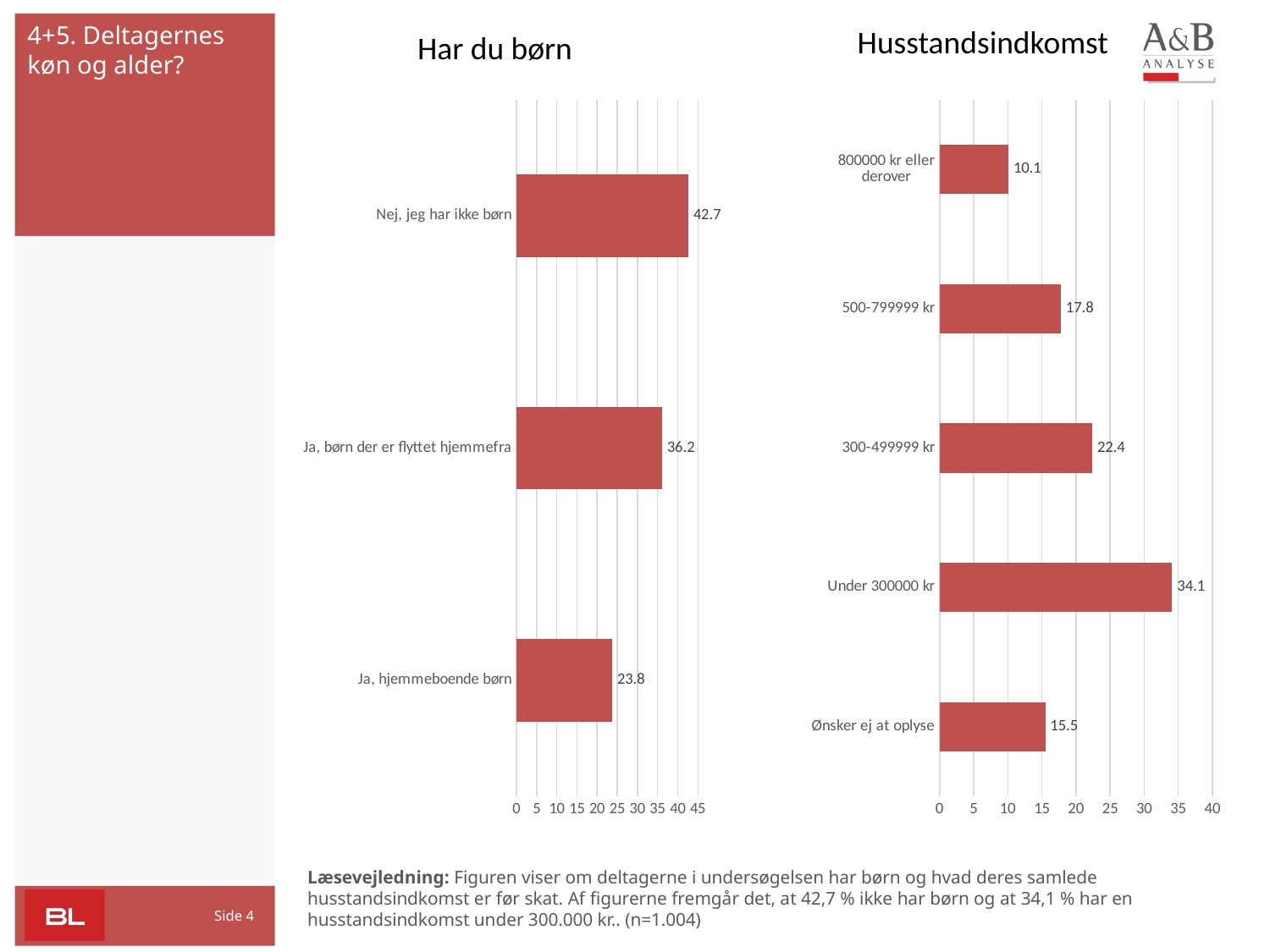
In the 'Har du børn' chart, which category has the lowest value? Ja, hjemmeboende børn In the 'Har du børn' chart, what is the value for 'Ja, hjemmeboende børn'? 23.8 In the 'Husstandsindkomst' chart, how many categories are shown? 5 In the 'Husstandsindkomst' chart, which category has the highest value? Under 300000 kr In the 'Husstandsindkomst' chart, what is the value for 'Ønsker ej at oplyse'? 15.5 What type of chart is the 'Husstandsindkomst' chart? Bar chart In the 'Har du børn' chart, what is the difference between 'Nej, jeg har ikke børn' and 'Ja, børn der er flyttet hjemmefra'? 6.5 In the 'Husstandsindkomst' chart, which category has the lowest value? 800000 kr eller derover In the 'Har du børn' chart, what is the value for 'Nej, jeg har ikke børn'? 42.7 In the 'Husstandsindkomst' chart, which is larger: '300-499999 kr' or '500-799999 kr'? 300-499999 kr In the 'Husstandsindkomst' chart, what is the value for '500-799999 kr'? 17.8 In the 'Har du børn' chart, how many categories are shown? 3